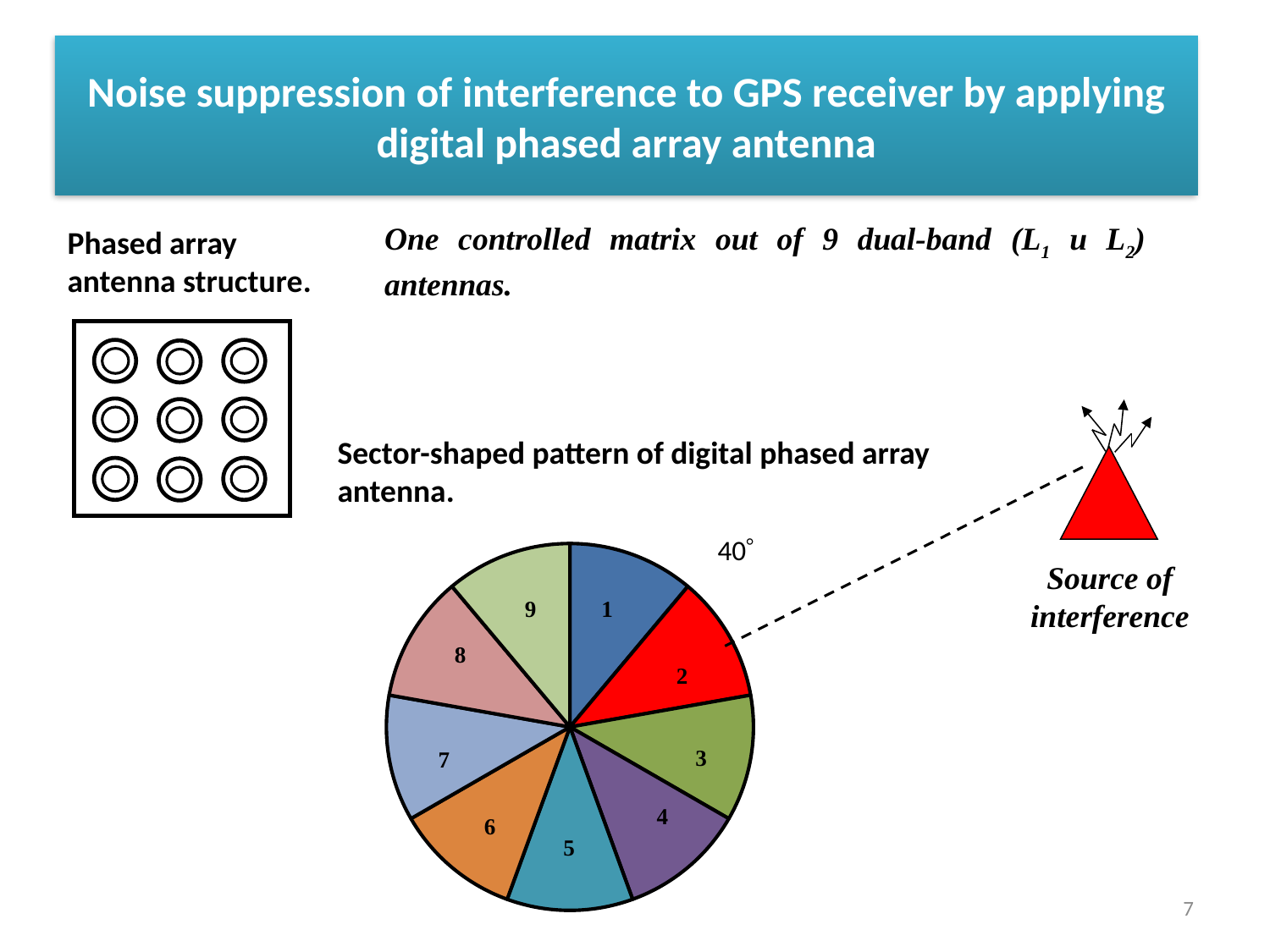
What is the lowest sector number shown in the pie chart? 1 What angle is labelled next to the pie chart of the sector-shaped pattern? 40° What kind of chart is the sector-shaped pattern of the digital phased array antenna? pie chart How many sectors does the sector-shaped pattern pie chart have? 9 What is the highest sector number shown in the pie chart? 9 Which sector of the pie chart is coloured red and points toward the source of interference? 2